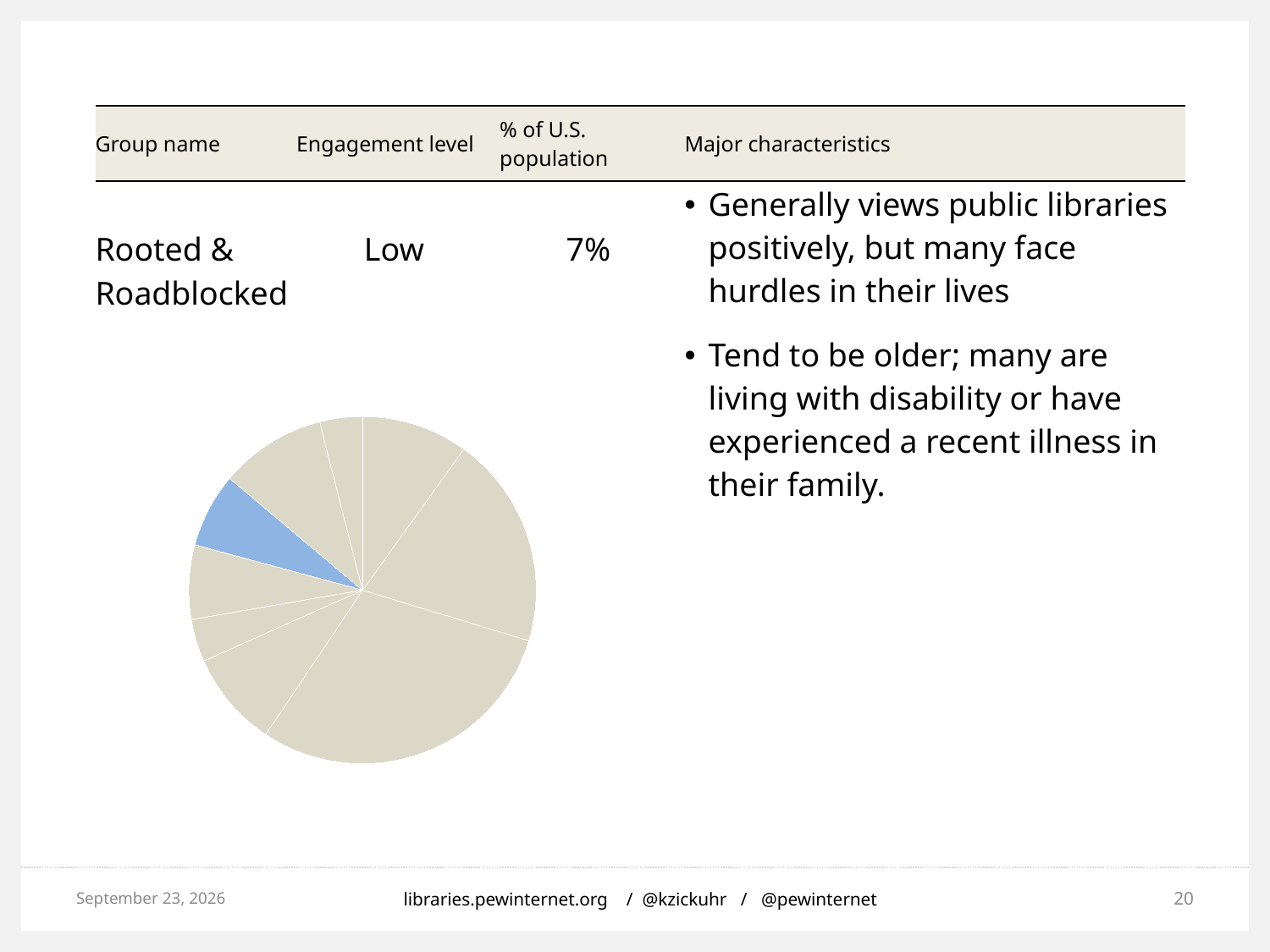
Does the pie chart include a legend? No What share of the U.S. population does the highlighted (blue) slice of the pie chart represent, according to the table on the slide? 7% What kind of chart is shown on the slide? pie chart What colour is the highlighted slice in the pie chart? blue Is the highlighted blue slice of the pie chart the largest slice? No